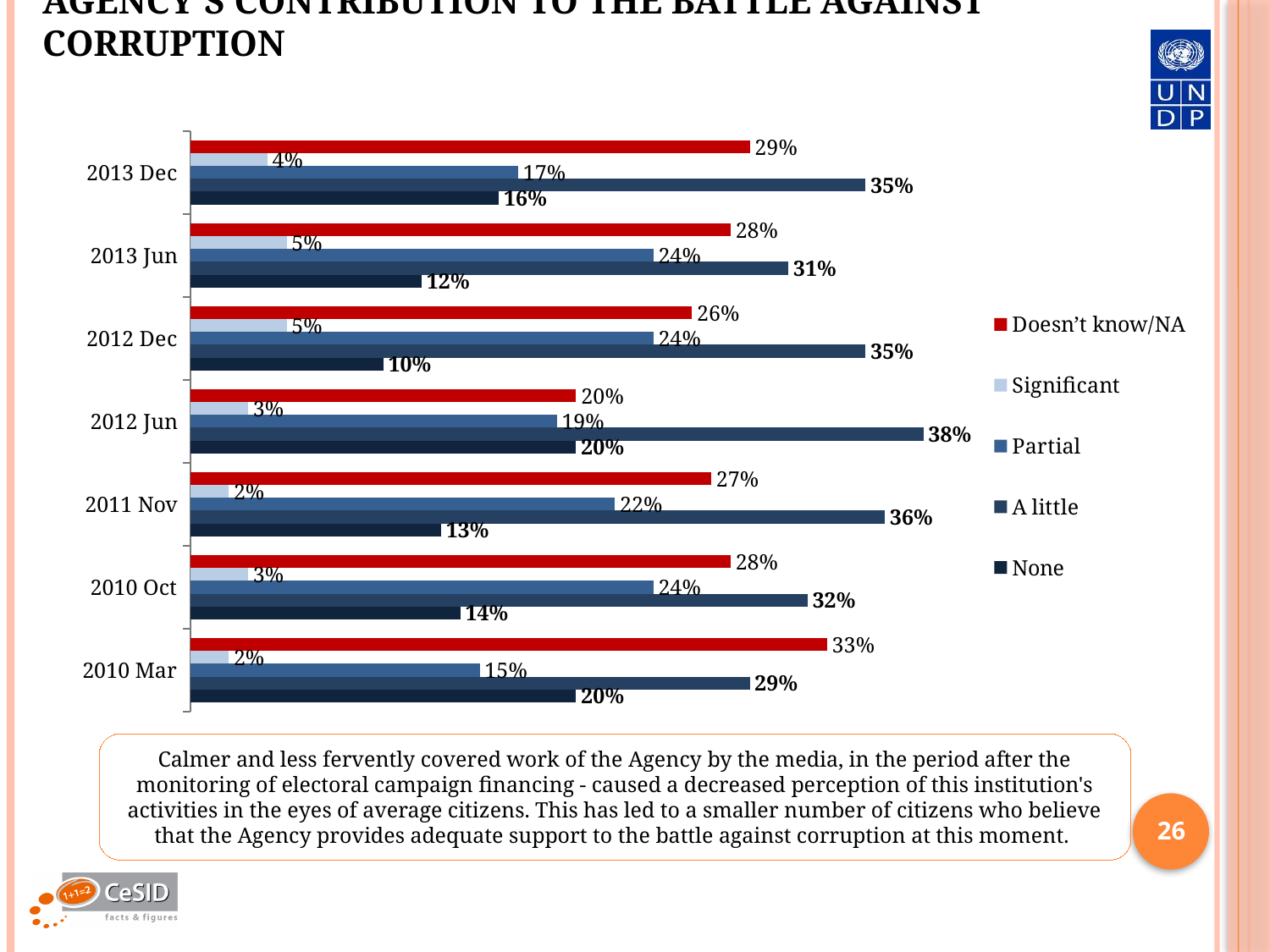
How many series does the legend list? 5 What is the value for "A little" in 2012 Jun? 38% What is the value for "None" in 2012 Dec? 10% Which is larger in 2010 Mar: "Doesn't know/NA" or "A little"? Doesn't know/NA In which period is the "A little" value highest? 2012 Jun How many time periods are shown on the chart? 7 What is the value for "Doesn't know/NA" in 2010 Mar? 33% What kind of chart is shown on the slide? Bar chart What is the value for "Partial" in 2013 Dec? 17% In which period is the "None" value lowest? 2012 Dec What is the difference between the "A little" and "None" values in 2013 Dec? 19% Which series is shown in red on the chart? Doesn't know/NA